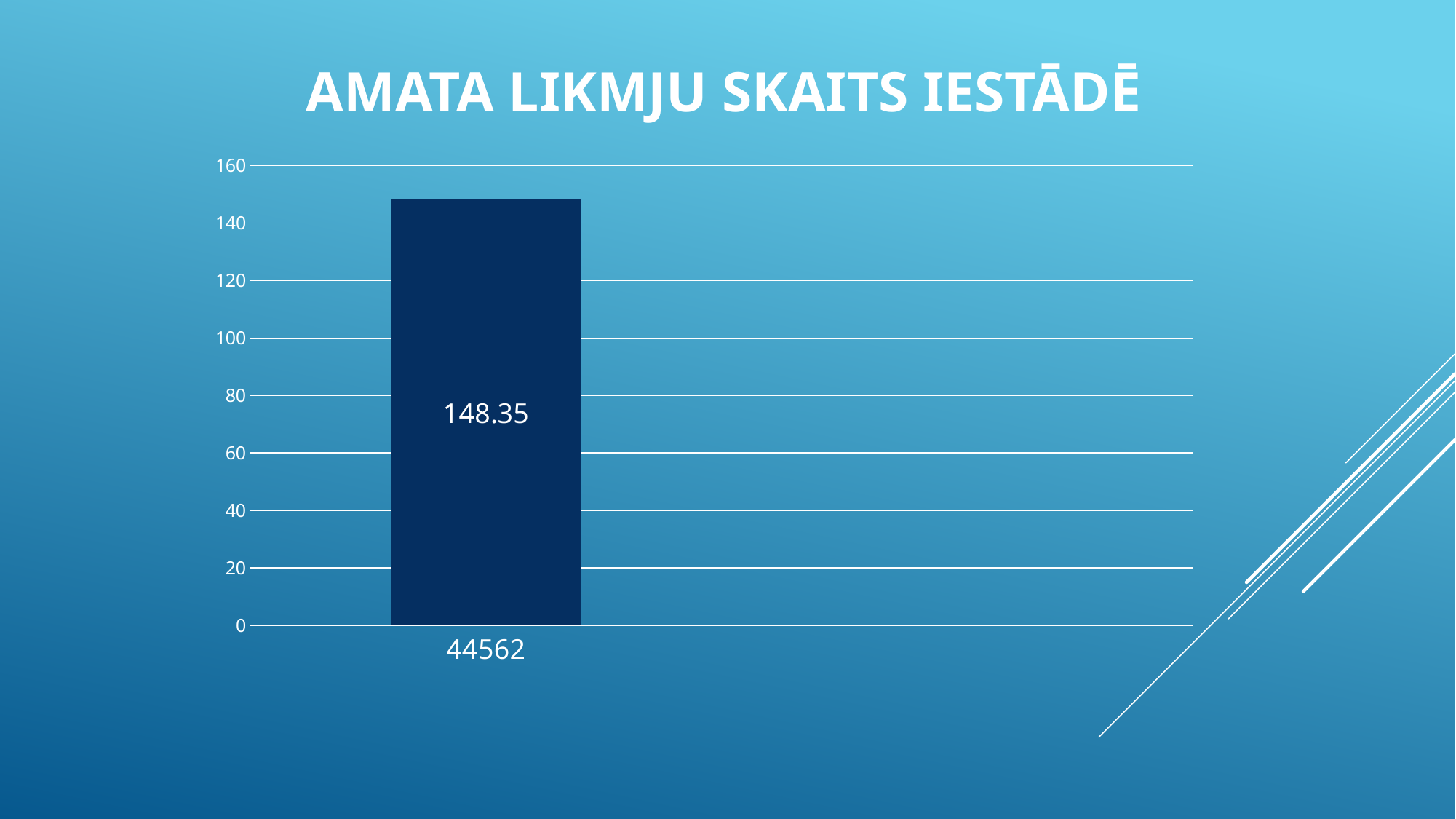
How many bars does the chart show? 1 What is the highest value shown on the vertical axis? 160 What is the category label shown under the bar? 44562 Is the value for 44562 greater or less than 140? greater What kind of chart is shown on the slide? bar chart What is the title of the chart? AMATA LIKMJU SKAITS IESTĀDĒ What is the value shown for the category labelled 44562? 148.35 Is the value for 44562 greater or less than 160? less